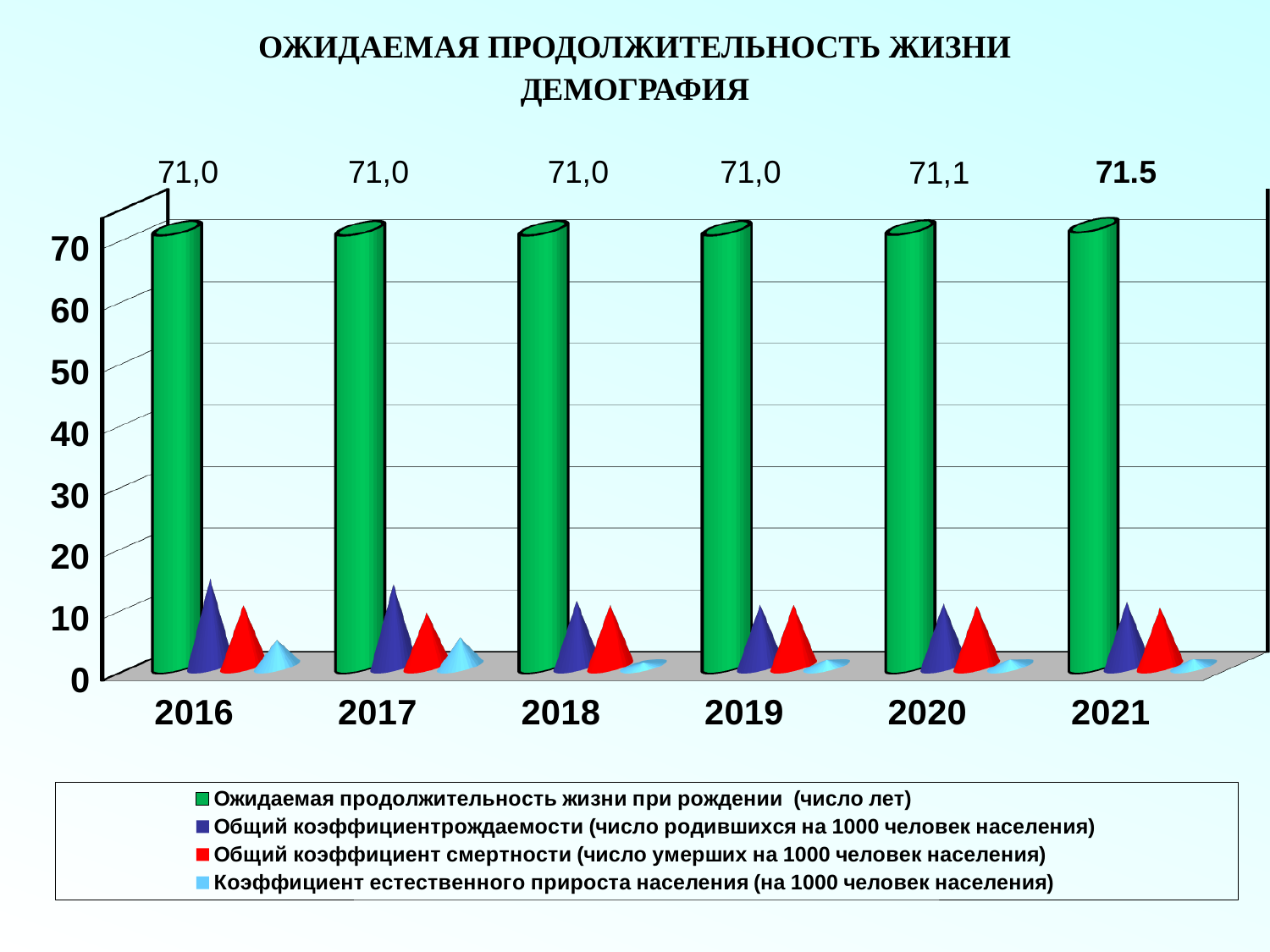
By how much does the life expectancy at birth in 2021 exceed that in 2019? 0.5 Which year has the highest life expectancy at birth? 2021 How many series does the legend list? 4 How many years are shown on the x axis? 6 Does the life expectancy at birth rise or fall from 2019 to 2021? Rise What is the life expectancy at birth value shown for 2016? 71,0 What kind of chart is shown on the slide? Bar chart In 2016, which is larger: the birth rate (blue cone) or the death rate (red cone)? Birth rate What is the life expectancy at birth value shown for 2021? 71.5 What is the life expectancy at birth value shown for 2020? 71,1 Is the birth rate (Общий коэффициент рождаемости) value for 2016 greater or less than 10? greater Which colour represents the natural population growth coefficient in the legend? Light blue